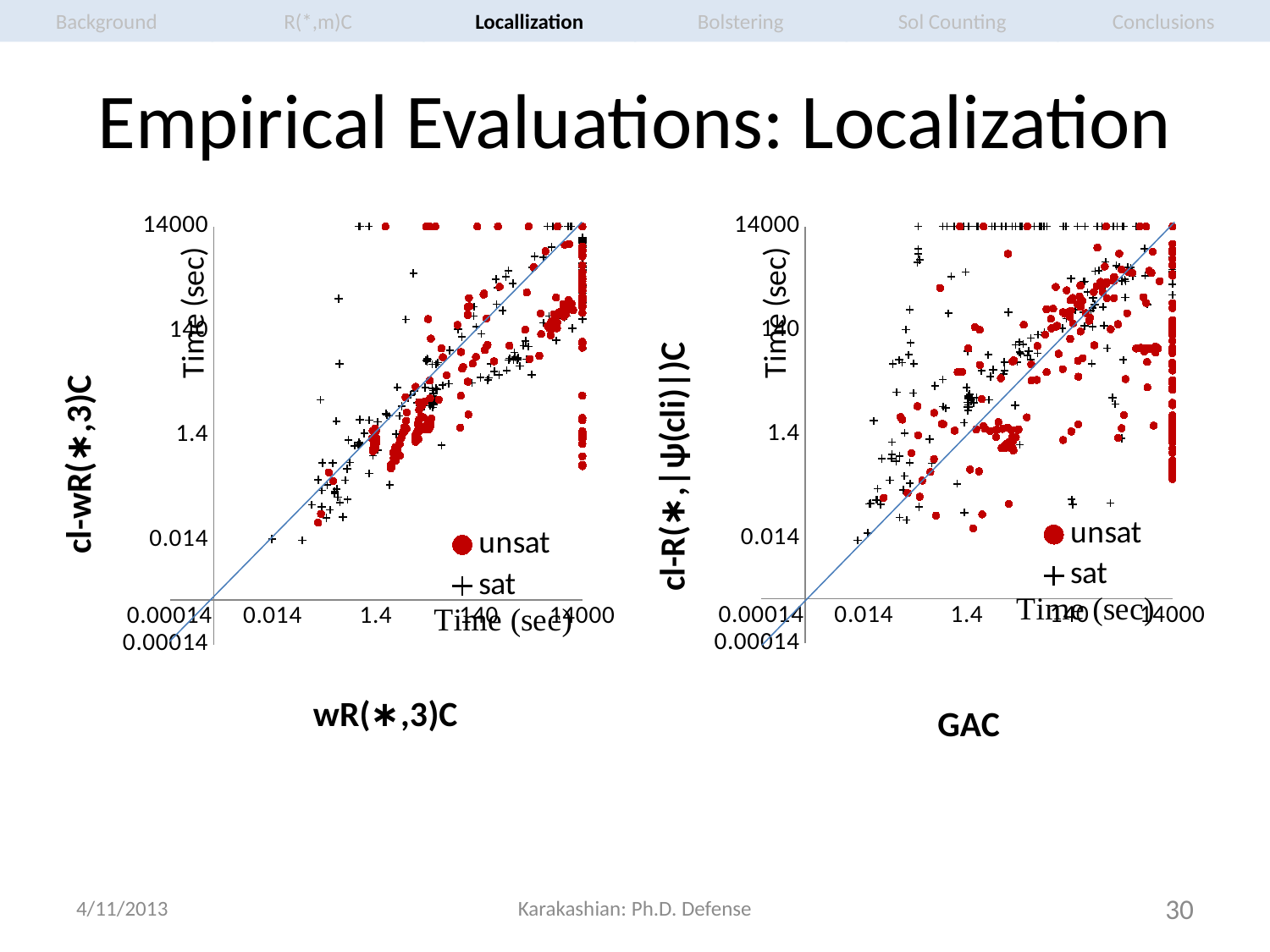
How many series does the legend of the right chart list? 2 In the left chart, which series is drawn with red circle markers? unsat What is the label of the x axis of the right chart (the method being compared)? GAC In the right chart, which series is drawn with plus-sign markers? sat What is the highest tick value shown on the y axis of the left chart? 14000 How many tick labels are shown on the x axis of the left chart? 5 What kind of chart is the left chart on the slide? scatter plot What is the lowest tick value shown on the x axis of the right chart? 0.00014 What is the label of the x axis of the left chart (the method being compared)? wR(∗,3)C What kind of chart is the right chart on the slide? scatter plot How many series does the legend of the left chart list? 2